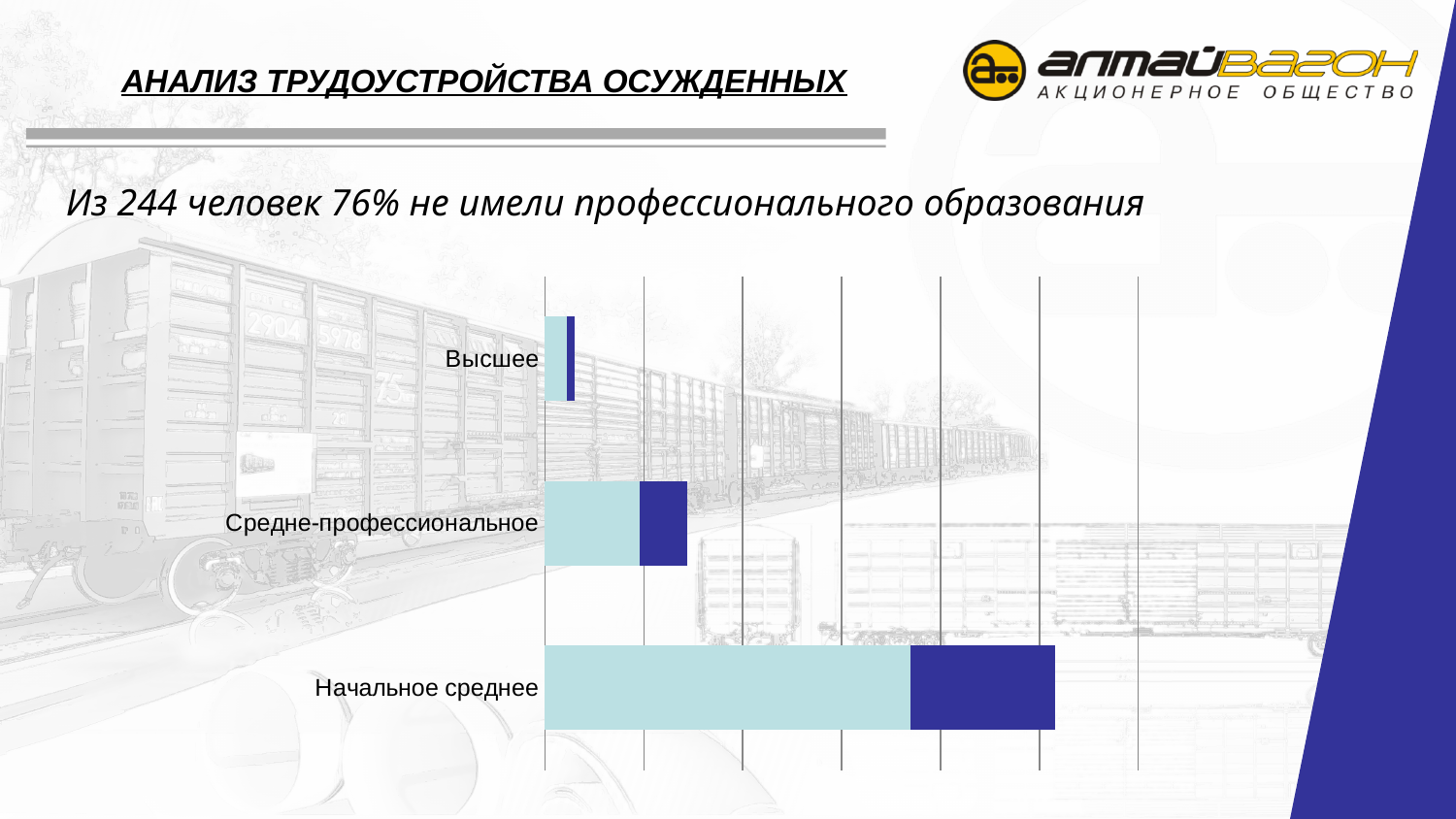
How many colour segments make up each bar on the chart? 2 Which category is listed at the top of the chart? Высшее Which bar is longer: Высшее or Средне-профессиональное? Средне-профессиональное Which bar is longer: Средне-профессиональное or Начальное среднее? Начальное среднее How many categories are shown on the chart? 3 Are the bars on the chart horizontal or vertical? horizontal Which category is listed at the bottom of the chart? Начальное среднее Which category has the shortest bar on the chart? Высшее What kind of chart is shown on the slide? bar chart Which category has the longest bar on the chart? Начальное среднее